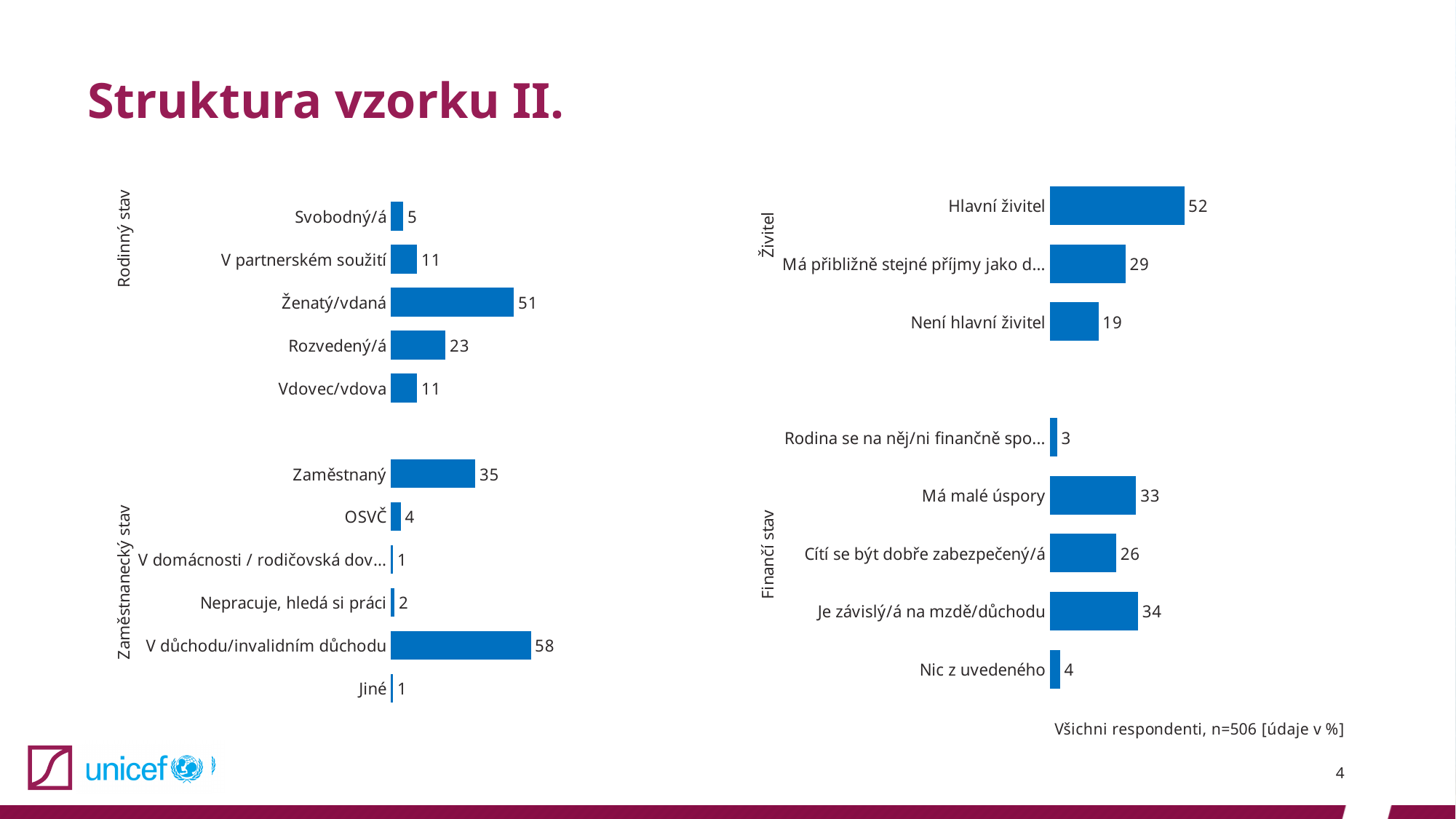
In the right chart, which is larger: Je závislý/á na mzdě/důchodu or Cítí se být dobře zabezpečený/á? Je závislý/á na mzdě/důchodu In the right chart, what is the value for Hlavní živitel? 52 In the left chart, which category in the Rodinný stav group has the highest value? Ženatý/vdaná In the right chart, which category in the Živitel group has the lowest value? Není hlavní živitel In the right chart, what is the difference between Hlavní živitel and Není hlavní živitel? 33 According to the note on the slide, how many respondents are in the sample? n=506 In the left chart, what is the value for V důchodu/invalidním důchodu? 58 In the left chart, what is the value for Ženatý/vdaná? 51 How many categories are in the Zaměstnanecký stav group of the left chart? 6 In the right chart, what is the value for Má malé úspory? 33 What kind of chart is shown on the right side of the slide? Bar chart In the left chart, what is the difference between Zaměstnaný and OSVČ? 31